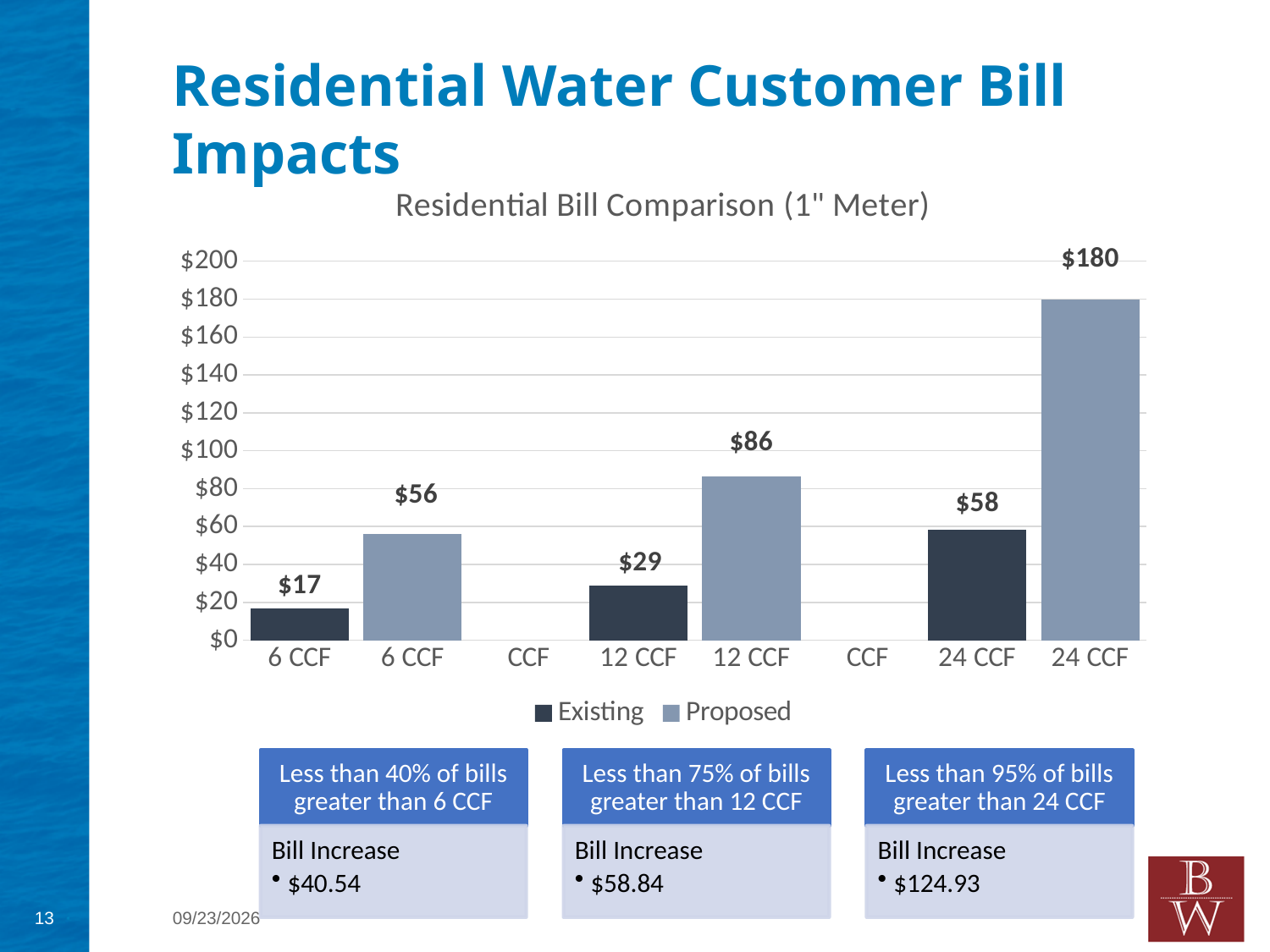
What is the difference between the Proposed and Existing bills at 24 CCF? $122 Which bar has the highest value on the chart? 24 CCF Proposed ($180) What is the difference between the Proposed and Existing bills at 12 CCF? $57 What kind of chart is shown on the slide? Bar chart What is the Proposed bill value for 12 CCF? $86 What is the Existing bill value for 6 CCF? $17 What is the Proposed bill value for 24 CCF? $180 Which is larger, the Proposed bill at 6 CCF or the Existing bill at 24 CCF? Existing bill at 24 CCF ($58) What is the Existing bill value for 24 CCF? $58 Which bar has the lowest value on the chart? 6 CCF Existing ($17) How many series does the legend list? 2 What is the title of the chart? Residential Bill Comparison (1" Meter)